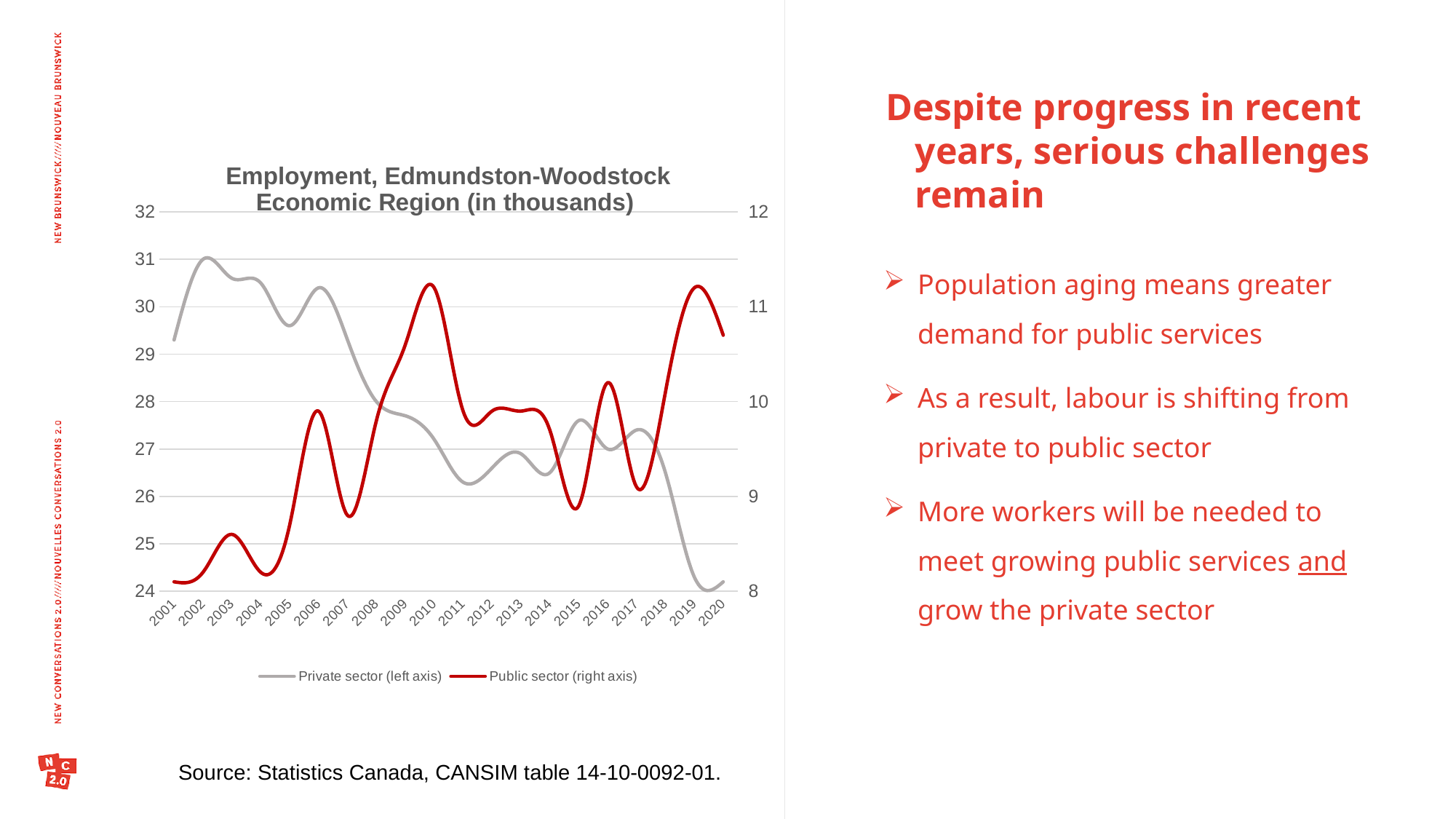
Is the Public sector value for 2010 greater or less than 11? greater Which series is plotted against the right axis? Public sector What kind of chart is shown on the slide? line chart How many series does the legend list? 2 Is the Private sector value for 2019 greater or less than 25? less In which year is the Private sector value highest? 2002 How many years are plotted along the x axis? 20 What is the title of the chart? Employment, Edmundston-Woodstock Economic Region (in thousands) Which is larger for the Public sector series, the value in 2001 or the value in 2020? 2020 Does the Public sector series rise or fall overall from 2001 to 2020? rise Does the Private sector series rise or fall overall from 2001 to 2020? fall Is the Public sector value for 2001 greater or less than 9? less